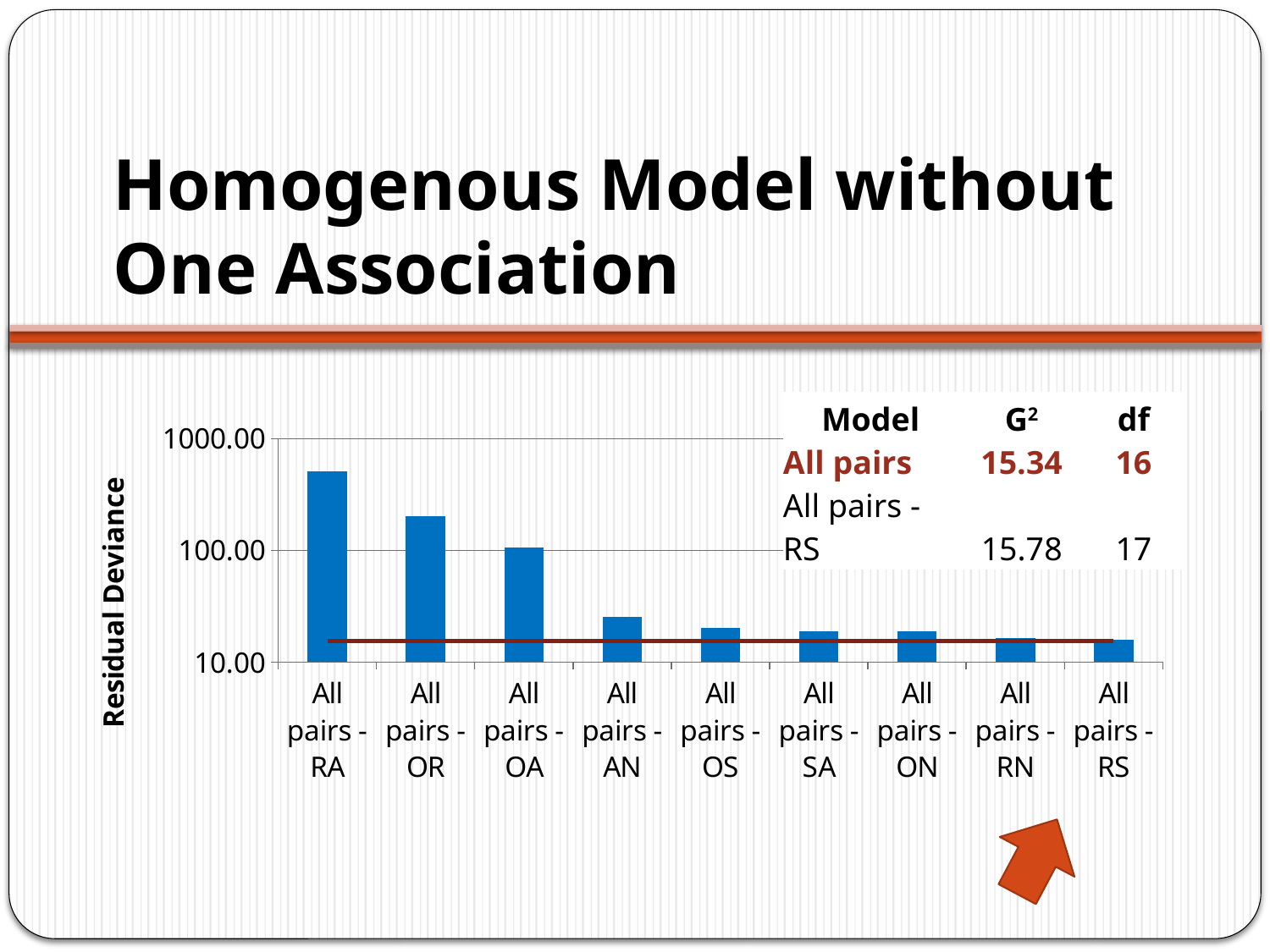
How many bars (models) are plotted in the chart? 9 According to the table on the slide, what is the G² value for the All pairs - RS model? 15.78 What is the label of the vertical axis of the chart? Residual Deviance Is the residual deviance for All pairs - RA greater or less than 100? greater Is the residual deviance for All pairs - AN greater or less than 100? less What kind of chart is shown on the slide? bar chart Do the residual deviance values rise or fall moving left to right along the x axis? fall Which has a larger residual deviance, All pairs - RA or All pairs - OR? All pairs - RA Is the residual deviance for All pairs - OR greater or less than 100? greater Which model has the highest residual deviance in the chart? All pairs - RA Which has a larger residual deviance, All pairs - OA or All pairs - AN? All pairs - OA